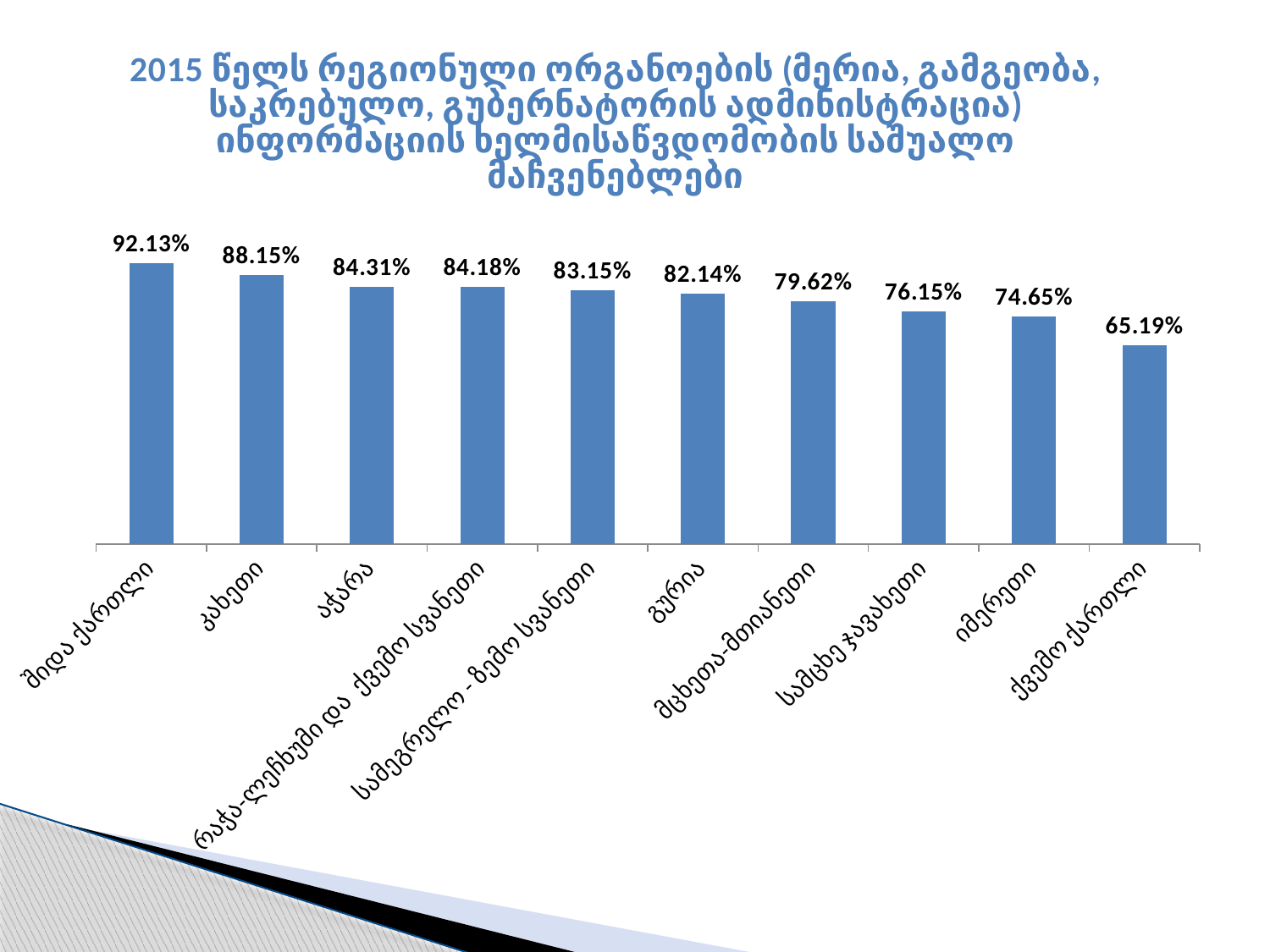
What is the value for გურია? 82.14% What kind of chart is shown on the slide? Bar chart Which category has the lowest value? ქვემო ქართლი Which is larger, the value for მცხეთა-მთიანეთი or the value for იმერეთი? მცხეთა-მთიანეთი What is the value for სამცხე ჯავახეთი? 76.15% What is the value for შიდა ქართლი? 92.13% How many categories are shown in the chart? 10 Do the values rise or fall from left to right along the x axis? Fall What is the difference between the values for შიდა ქართლი and ქვემო ქართლი? 26.94% Which category has the highest value? შიდა ქართლი What is the difference between the values for კახეთი and აჭარა? 3.84% What is the value for იმერეთი? 74.65%